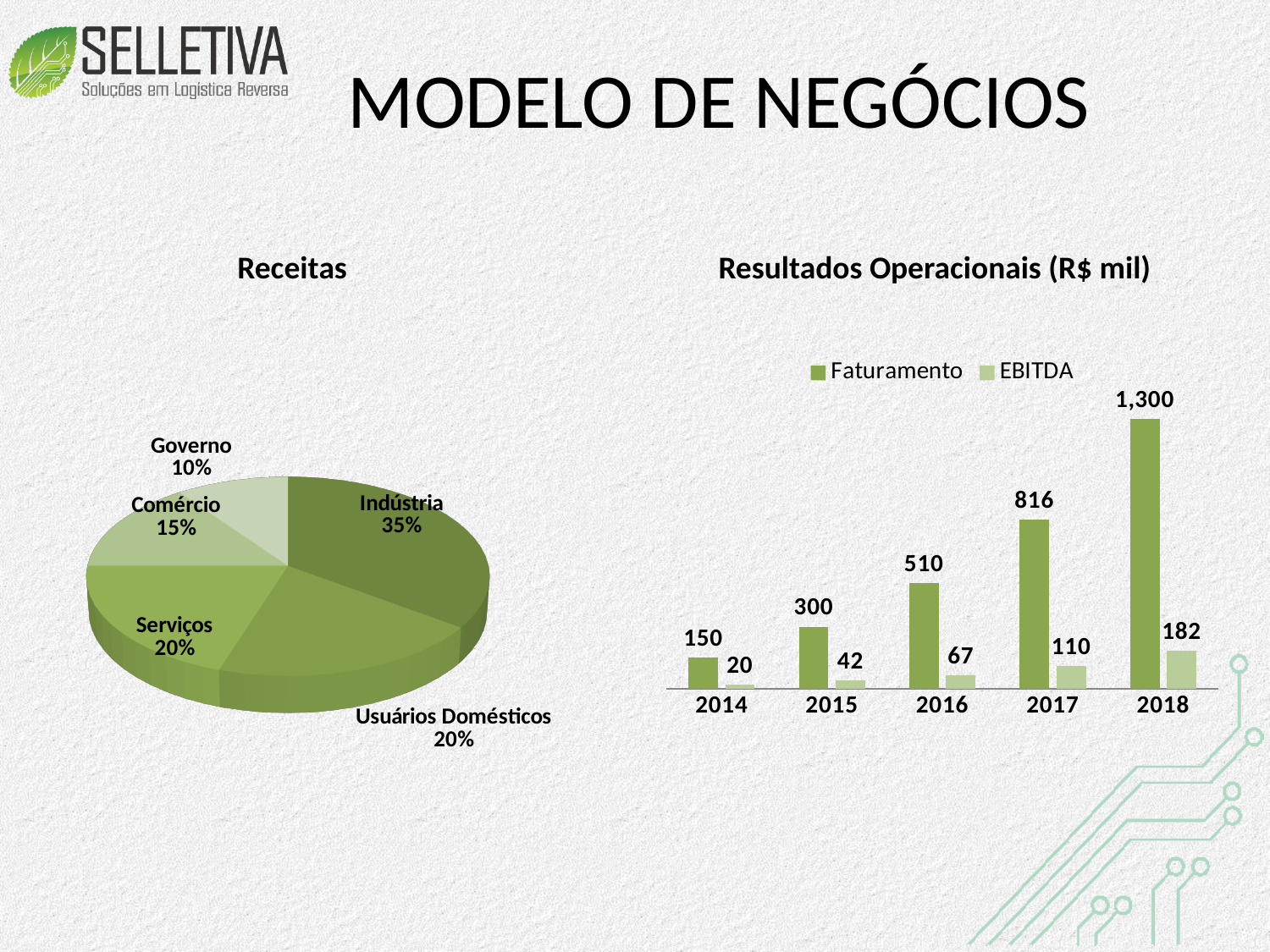
In the 'Resultados Operacionais (R$ mil)' chart, which year has the highest Faturamento? 2018 In the 'Receitas' chart, which category has the smallest share? Governo In the 'Receitas' chart, what share does Indústria have? 35% In the 'Receitas' chart, how many categories are shown? 5 In the 'Resultados Operacionais (R$ mil)' chart, what is the difference between Faturamento and EBITDA in 2018? 1,118 What kind of chart is the 'Resultados Operacionais (R$ mil)' chart? Bar chart In the 'Resultados Operacionais (R$ mil)' chart, what is the EBITDA value for 2016? 67 In the 'Resultados Operacionais (R$ mil)' chart, how many series does the legend list? 2 What kind of chart is the 'Receitas' chart? Pie chart In the 'Receitas' chart, what share does Comércio have? 15% In the 'Resultados Operacionais (R$ mil)' chart, does Faturamento rise or fall from 2014 to 2018? Rise In the 'Resultados Operacionais (R$ mil)' chart, what is the Faturamento value for 2017? 816